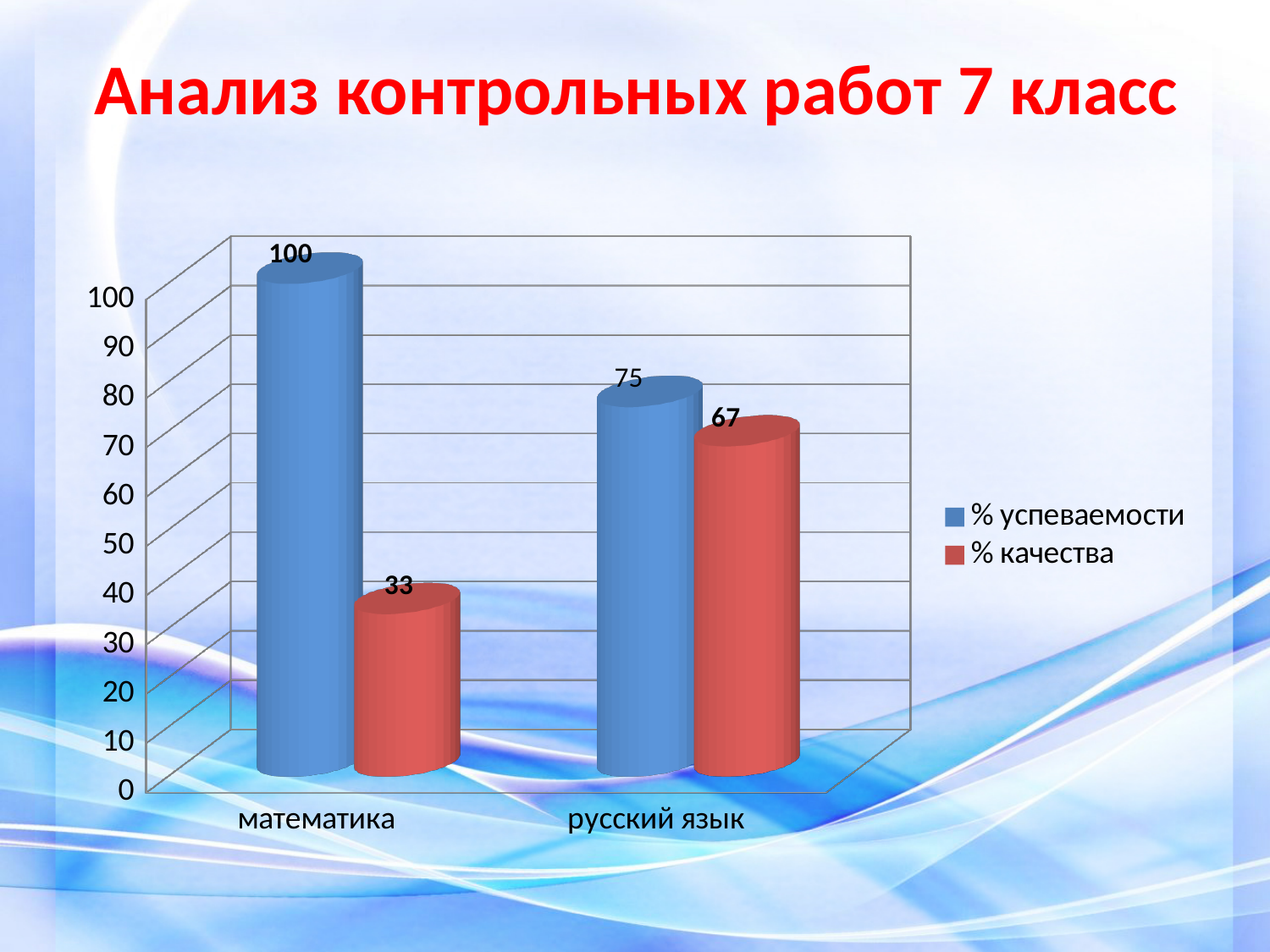
What type of chart is shown on the slide? bar chart What is the difference in % качества between русский язык and математика? 34 Is the % успеваемости for математика larger or smaller than for русский язык? larger What is the % качества value for математика? 33 Which subject has the higher % качества? русский язык What is the % успеваемости value for математика? 100 What is the difference between % успеваемости and % качества for математика? 67 How many series does the legend list? 2 What is the % качества value for русский язык? 67 What is the % успеваемости value for русский язык? 75 Which subject has the lower % успеваемости? русский язык How many subjects are shown on the x axis? 2